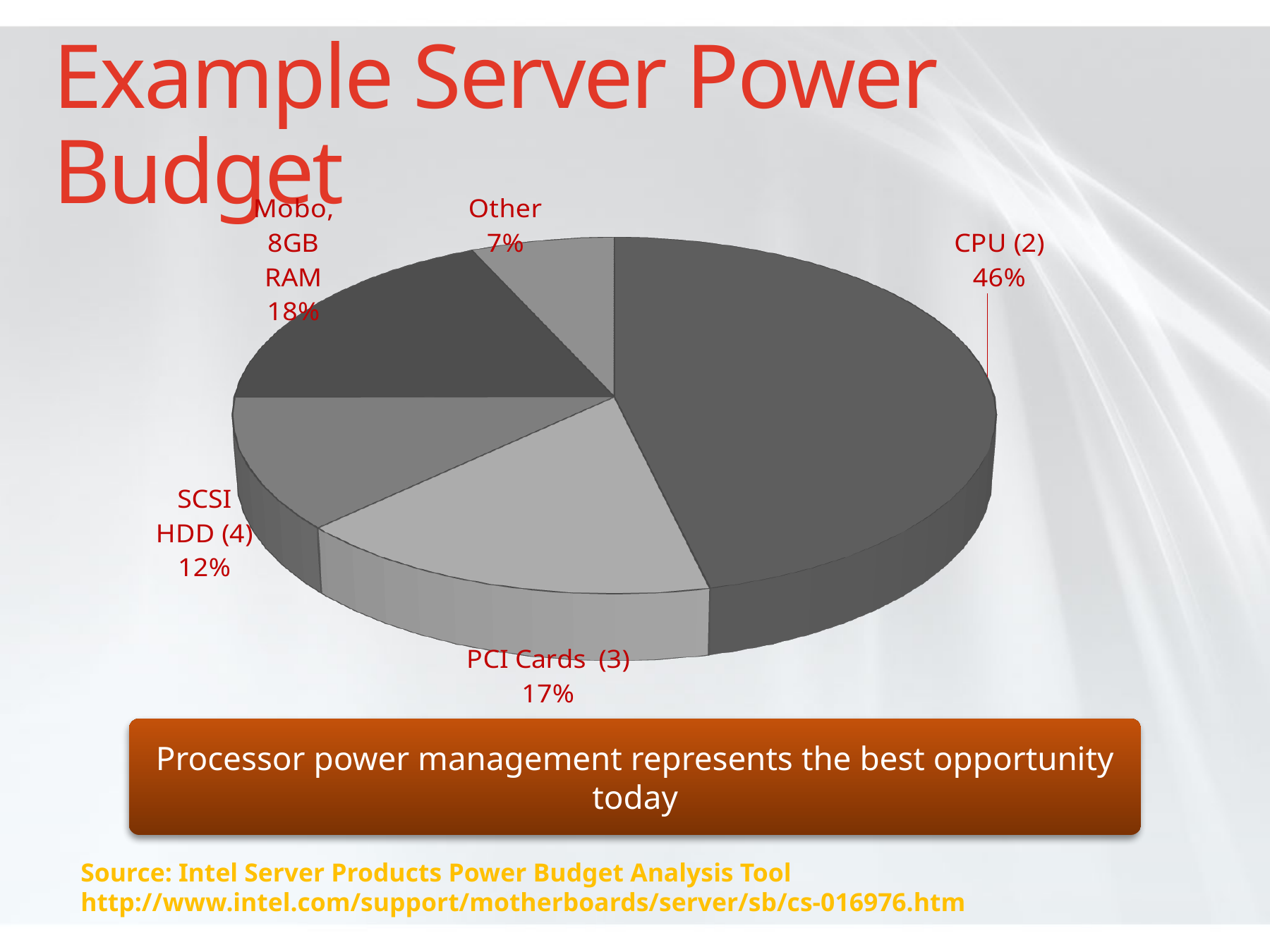
Which slice has the smallest share of the power budget? Other What is the title of the slide containing the chart? Example Server Power Budget What share of the server power budget does CPU (2) account for? 46% What percentage is shown for Mobo, 8GB RAM? 18% Which is larger, the share for PCI Cards (3) or the share for SCSI HDD (4)? PCI Cards (3) What kind of chart is shown on the slide? Pie chart Which component has the largest share of the power budget? CPU (2) What percentage is shown for the Other slice? 7% What percentage is shown for PCI Cards (3)? 17% What percentage is shown for SCSI HDD (4)? 12% What is the difference in percentage points between CPU (2) and Mobo, 8GB RAM? 28 How many slices does the pie chart have? 5